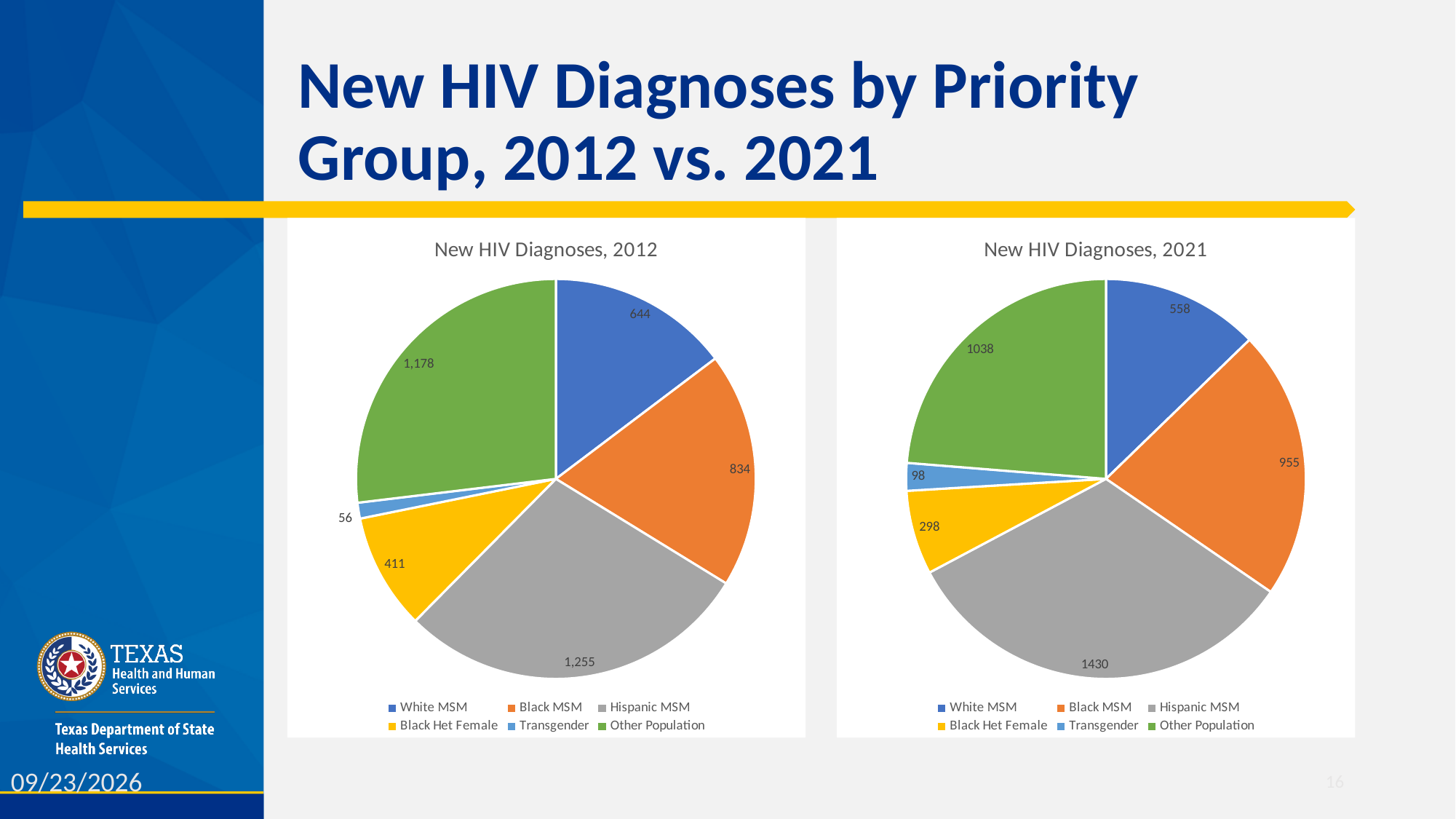
How many slices does the New HIV Diagnoses, 2021 pie chart have? 6 In the New HIV Diagnoses, 2012 chart, what is the value for Hispanic MSM? 1,255 In the New HIV Diagnoses, 2012 chart, what is the value for Transgender? 56 In the New HIV Diagnoses, 2012 chart, what colour is the Other Population slice? Green In the New HIV Diagnoses, 2012 chart, what is the difference between Hispanic MSM and Other Population? 77 What type of chart is New HIV Diagnoses, 2012? Pie chart In the New HIV Diagnoses, 2012 chart, which priority group has the smallest slice? Transgender In the New HIV Diagnoses, 2021 chart, which priority group has the largest slice? Hispanic MSM Which is larger: White MSM in the 2012 chart or White MSM in the 2021 chart? White MSM in the 2012 chart In the New HIV Diagnoses, 2021 chart, what is the value for Black Het Female? 298 In the New HIV Diagnoses, 2021 chart, what is the value for Black MSM? 955 In the New HIV Diagnoses, 2021 chart, how much larger is Hispanic MSM than Black MSM? 475